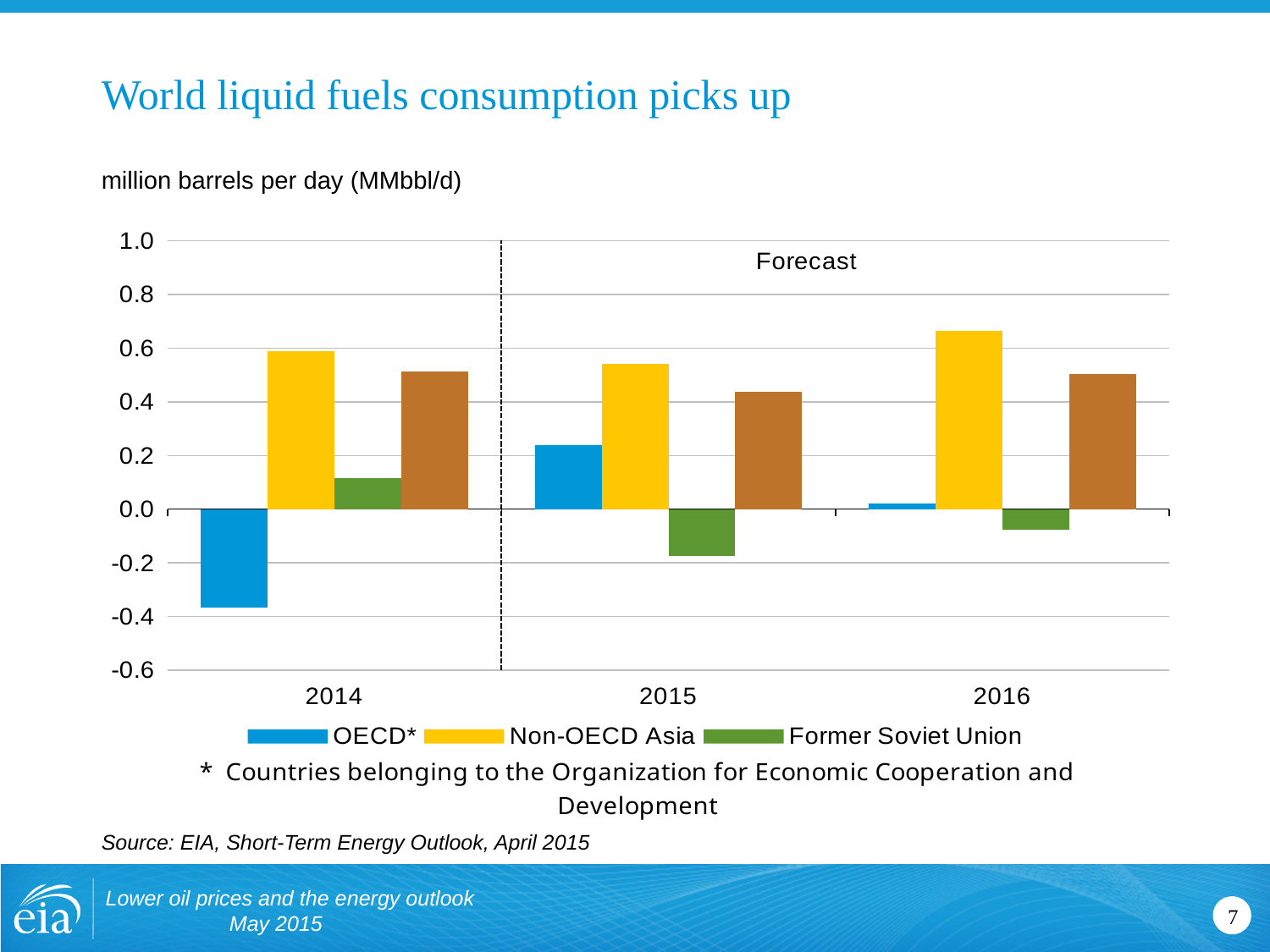
In which year is the OECD* value lowest? 2014 What kind of chart is shown on the slide? bar chart Which is larger, the Non-OECD Asia value in 2015 or in 2016? 2016 Is the value for OECD* in 2014 greater or less than -0.2? less Is the value for Non-OECD Asia in 2016 greater or less than 0.6? greater Which is larger, the Former Soviet Union value in 2014 or in 2016? 2014 In which year is the Non-OECD Asia value highest? 2016 Is the value for OECD* in 2015 greater or less than 0.4? less How many series does the chart's legend list? 3 Does the OECD* value rise or fall from 2014 to 2015? rise How many years are shown on the x axis of the chart? 3